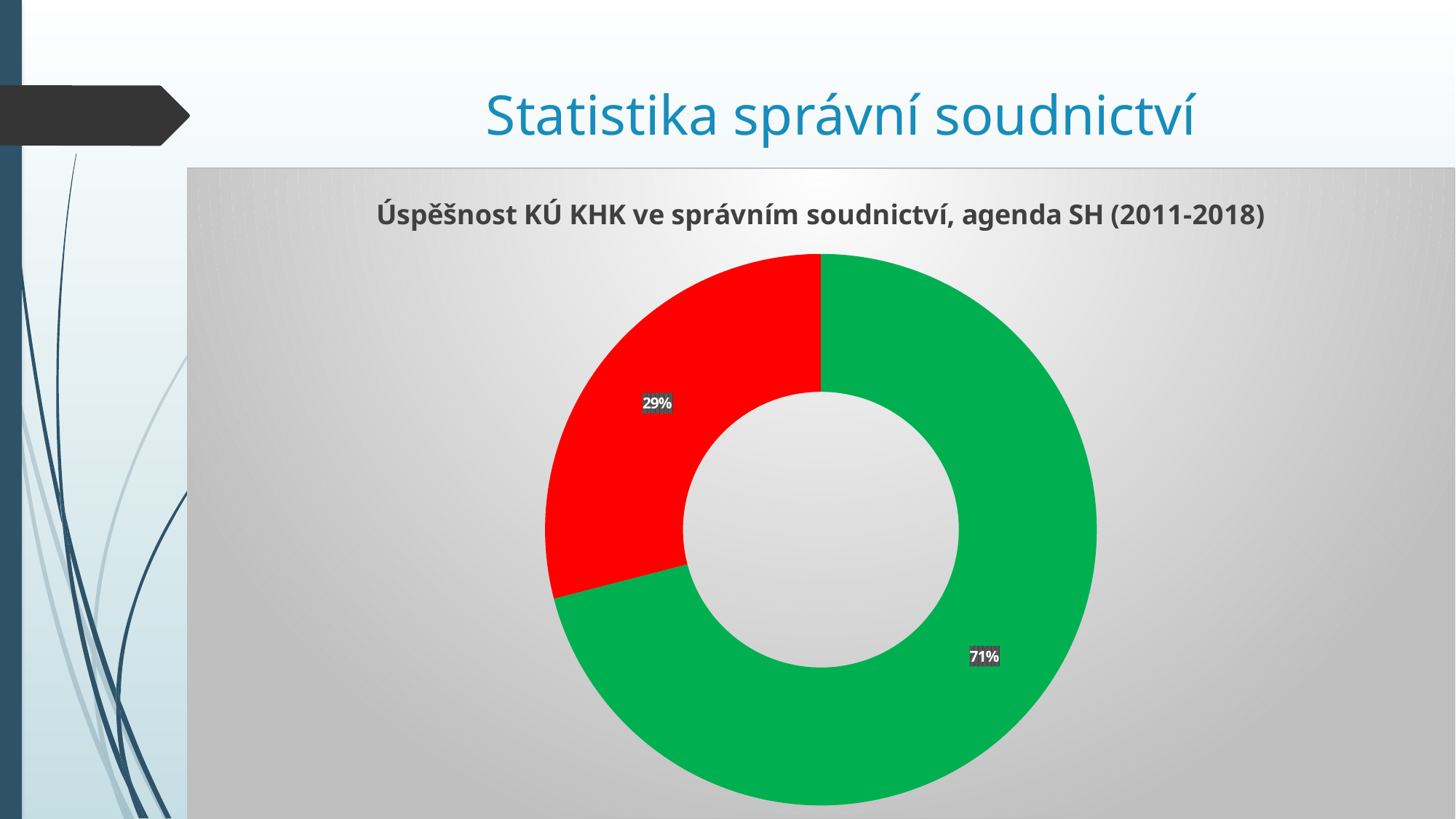
What percentage is shown on the green slice? 71% What colours are used for the two slices of the chart? Green and red Which slice is the smallest? The red slice (29%) What share of the whole does the green slice represent? 71% What kind of chart is shown on the slide? Doughnut (pie) chart What is the title of the chart? Úspěšnost KÚ KHK ve správním soudnictví, agenda SH (2011-2018) What percentage is shown on the red slice? 29% Which slice is the largest? The green slice (71%) What share of the whole does the red slice represent? 29% What is the difference in percentage points between the green slice and the red slice? 42 percentage points How many slices does the doughnut chart have? 2 Which slice is larger, the green one or the red one? The green one